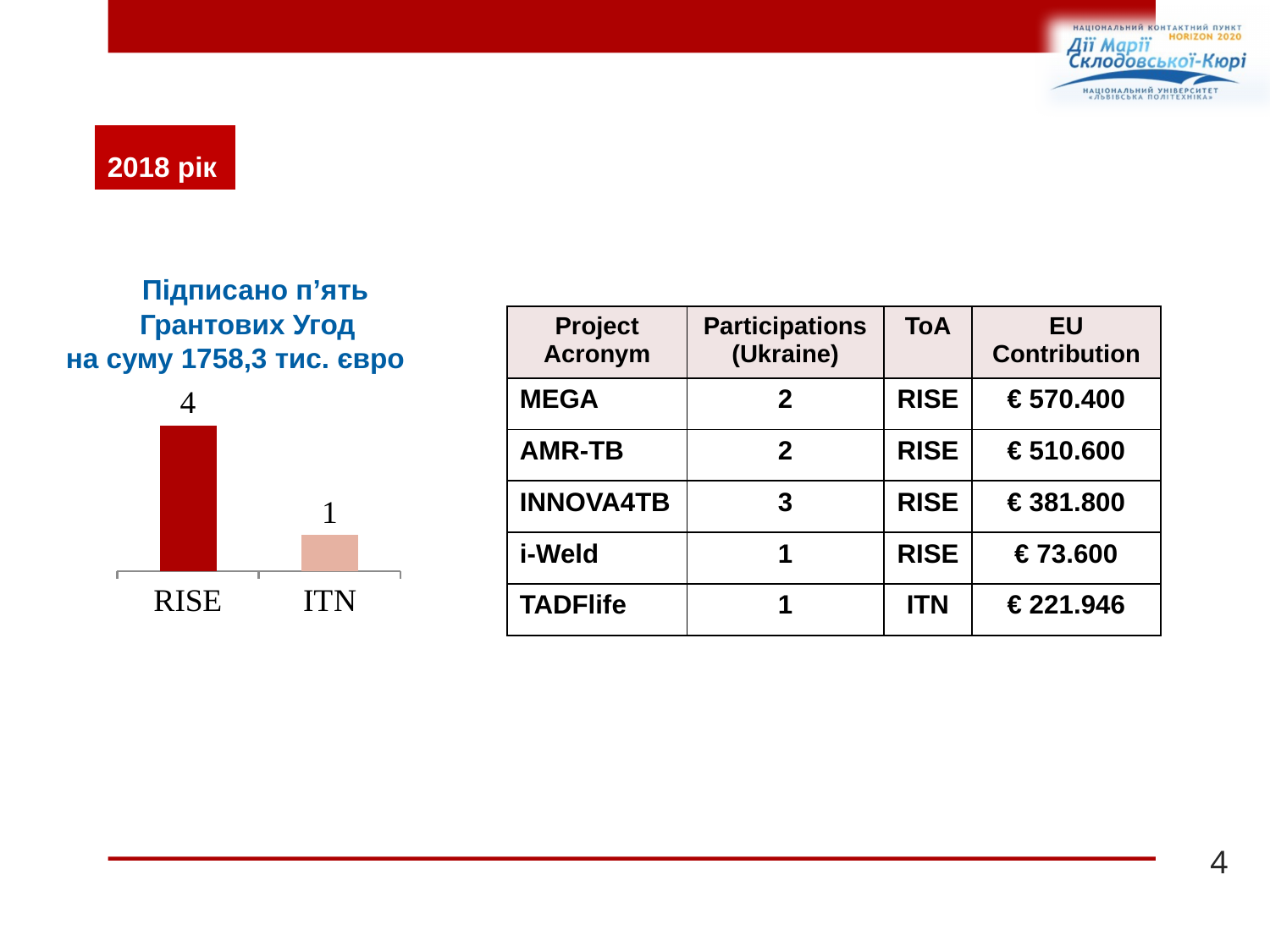
What is the total of the values shown in the bar chart? 5 Which is larger in the bar chart, RISE or ITN? RISE What colour is the RISE bar in the chart? dark red Do the values in the bar chart rise or fall from RISE to ITN? fall What is the difference between the values for RISE and ITN in the bar chart? 3 How many categories are shown in the bar chart? 2 Which category has the lowest value in the bar chart? ITN Which category has the highest value in the bar chart? RISE What is the value for RISE in the bar chart? 4 What is the value for ITN in the bar chart? 1 What kind of chart is shown on the slide? bar chart